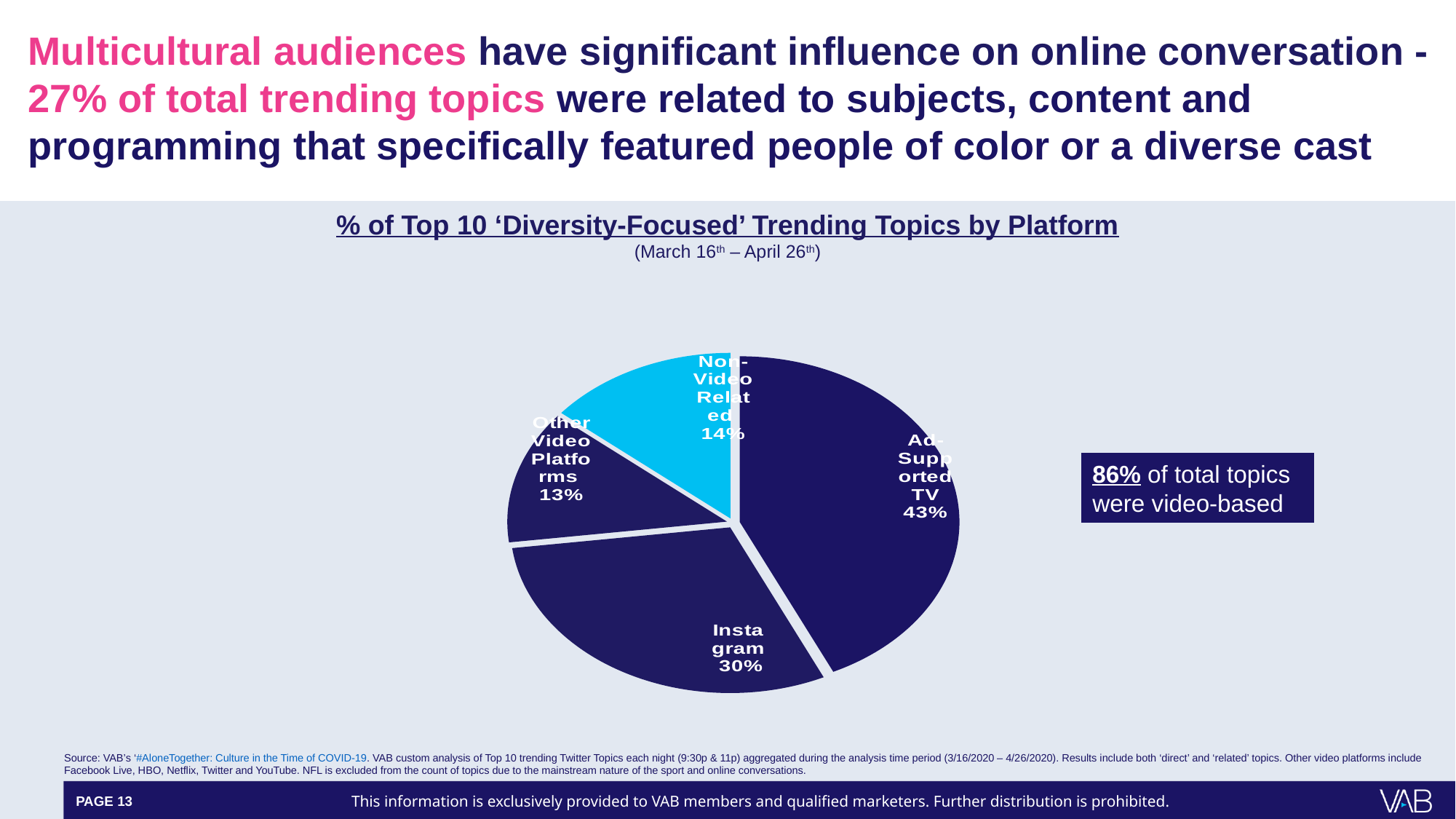
What kind of chart is shown on the slide? pie chart How many slices does the pie chart have? 4 What is the difference between the Ad-Supported TV share and the Instagram share? 13% What share of the pie does Ad-Supported TV account for? 43% Which is larger, the Instagram slice or the Non-Video Related slice? Instagram What share of the pie does Other Video Platforms account for? 13% What share of the pie does Non-Video Related account for? 14% Which slice of the pie is the smallest? Other Video Platforms What is the title of the chart? % of Top 10 'Diversity-Focused' Trending Topics by Platform Which slice of the pie is the largest? Ad-Supported TV What share of the pie does Instagram account for? 30% What is the combined share of Ad-Supported TV and Instagram? 73%